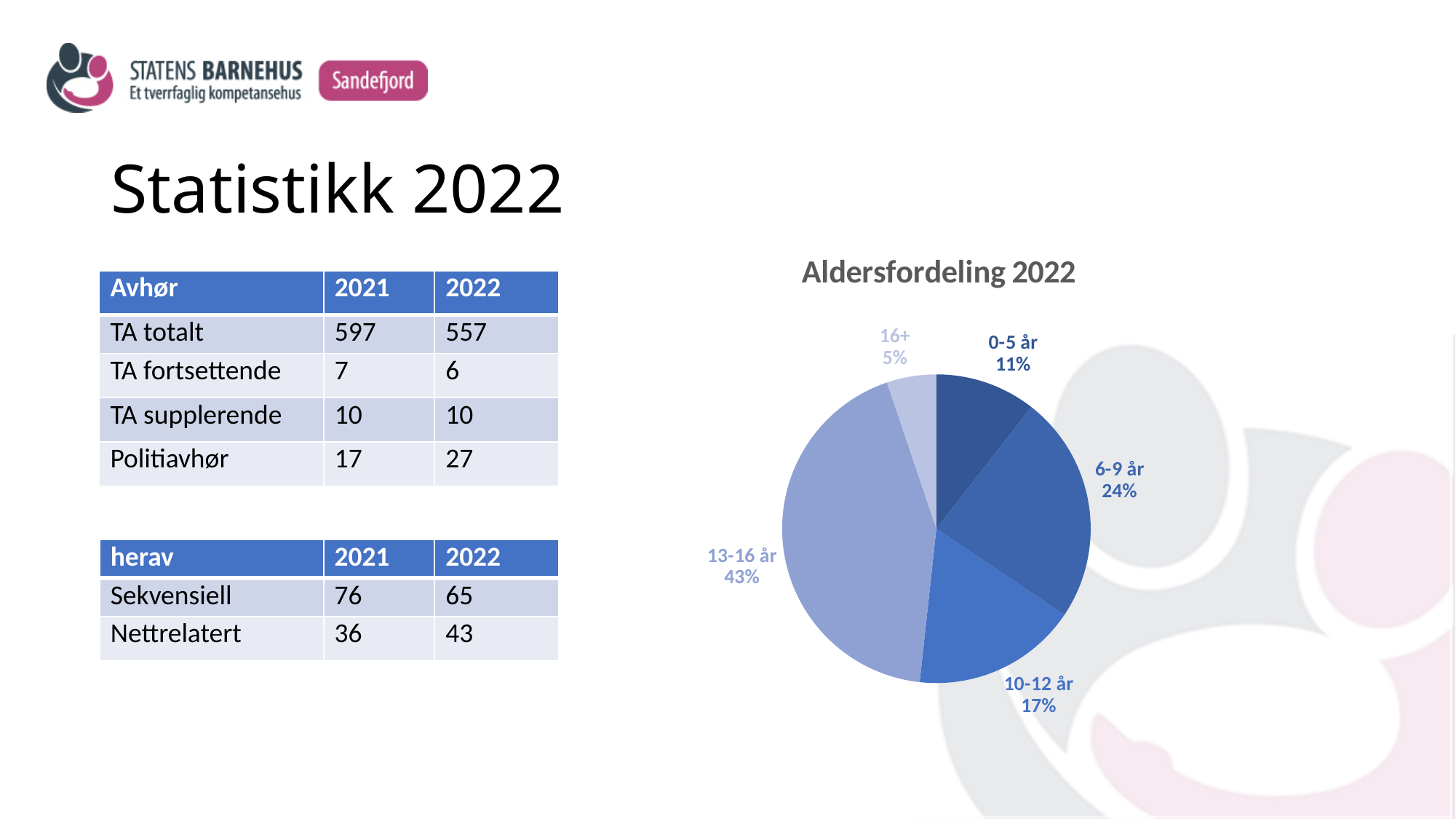
Which slice is larger, 6-9 år or 10-12 år? 6-9 år What is the value for the 0-5 år slice? 11% What share of the pie does the 13-16 år slice represent? 43% What is the difference in percentage points between the 13-16 år slice and the 10-12 år slice? 26 What type of chart is shown on the slide? pie chart What is the value for the 16+ slice? 5% Which age group has the largest share of the pie? 13-16 år What is the title of the pie chart? Aldersfordeling 2022 Which age group has the smallest share of the pie? 16+ What is the combined share of the 0-5 år and 6-9 år slices? 35% How many slices does the pie chart have? 5 What is the value for the 6-9 år slice? 24%